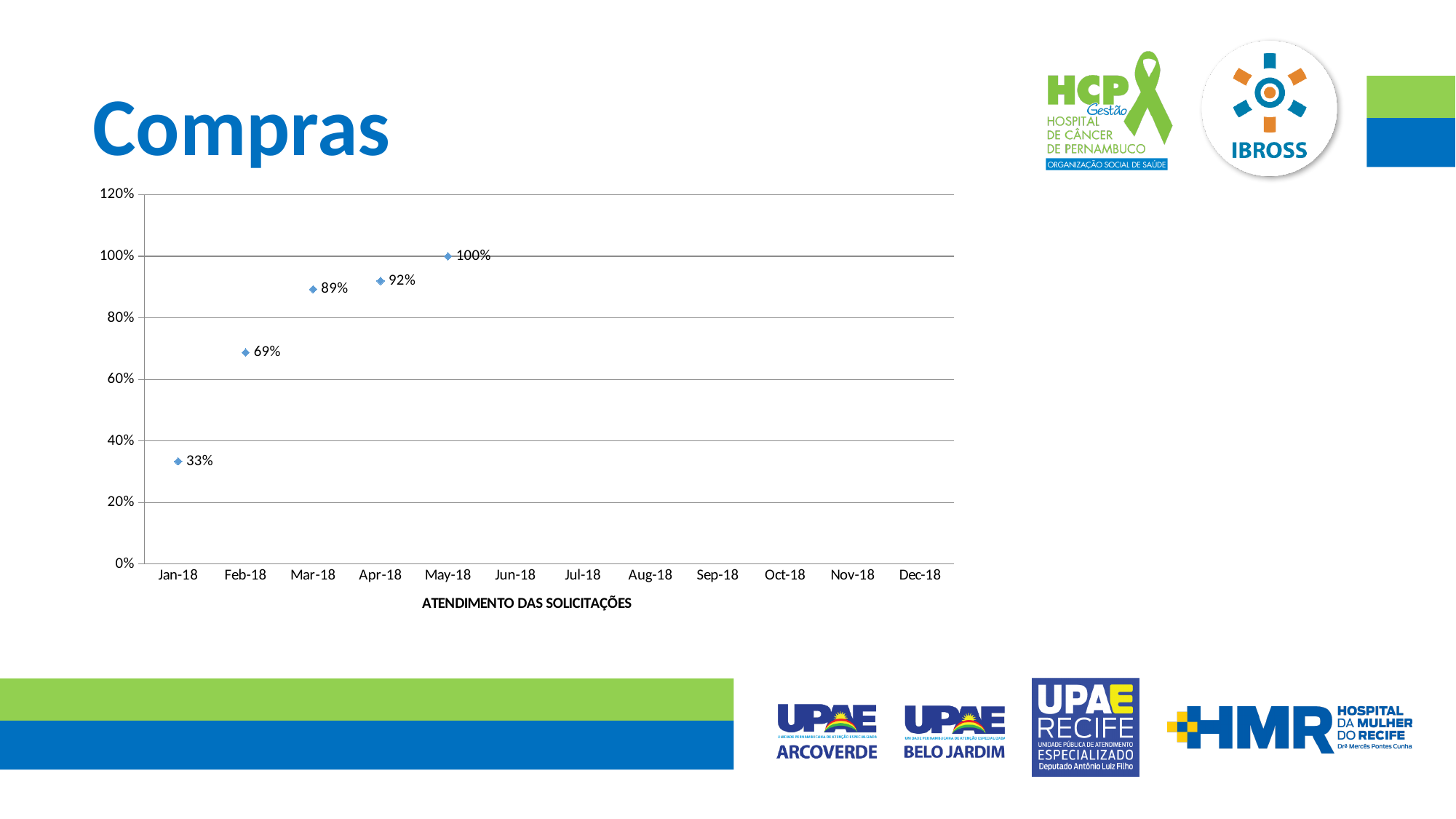
What is the difference between the values for May-18 and Jan-18? 67% What is the value for Jan-18? 33% What is the value for Mar-18? 89% What is the value for Feb-18? 69% Which month has the lowest value? Jan-18 What is the value for Apr-18? 92% What is the label shown below the x axis of the chart? ATENDIMENTO DAS SOLICITAÇÕES Which month has the highest value? May-18 What is the value for May-18? 100% Do the values rise or fall from Jan-18 to May-18? rise How many data points are plotted on the chart? 5 Which is larger, the value for Feb-18 or the value for Mar-18? Mar-18